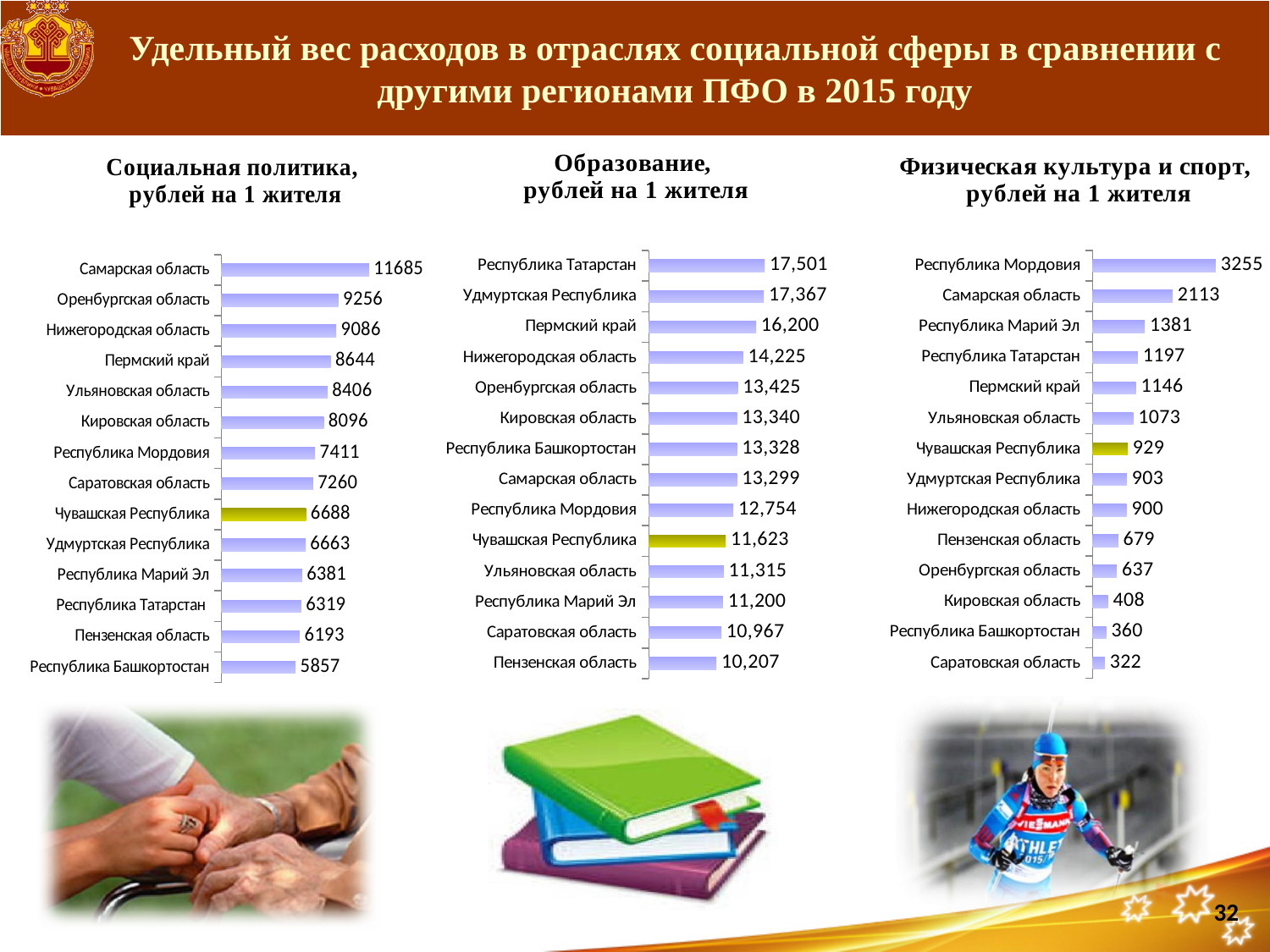
In the chart 'Социальная политика, рублей на 1 жителя', what is the difference between Самарская область and Оренбургская область? 2429 In the chart 'Физическая культура и спорт, рублей на 1 жителя', what is the value for Республика Мордовия? 3255 In the chart 'Социальная политика, рублей на 1 жителя', which region has the highest value? Самарская область In the chart 'Социальная политика, рублей на 1 жителя', what is the value for Чувашская Республика? 6688 In the chart 'Физическая культура и спорт, рублей на 1 жителя', which region's bar is highlighted in a different colour (yellow-green)? Чувашская Республика In the chart 'Образование, рублей на 1 жителя', how many regions are shown? 14 In the chart 'Физическая культура и спорт, рублей на 1 жителя', what is the difference between Чувашская Республика and Саратовская область? 607 In the chart 'Образование, рублей на 1 жителя', which is larger: Кировская область or Республика Башкортостан? Кировская область In the chart 'Образование, рублей на 1 жителя', what is the value for Республика Татарстан? 17,501 In the chart 'Образование, рублей на 1 жителя', which region has the lowest value? Пензенская область In the chart 'Социальная политика, рублей на 1 жителя', which region has the lowest value? Республика Башкортостан What type of chart is 'Физическая культура и спорт, рублей на 1 жителя'? Bar chart